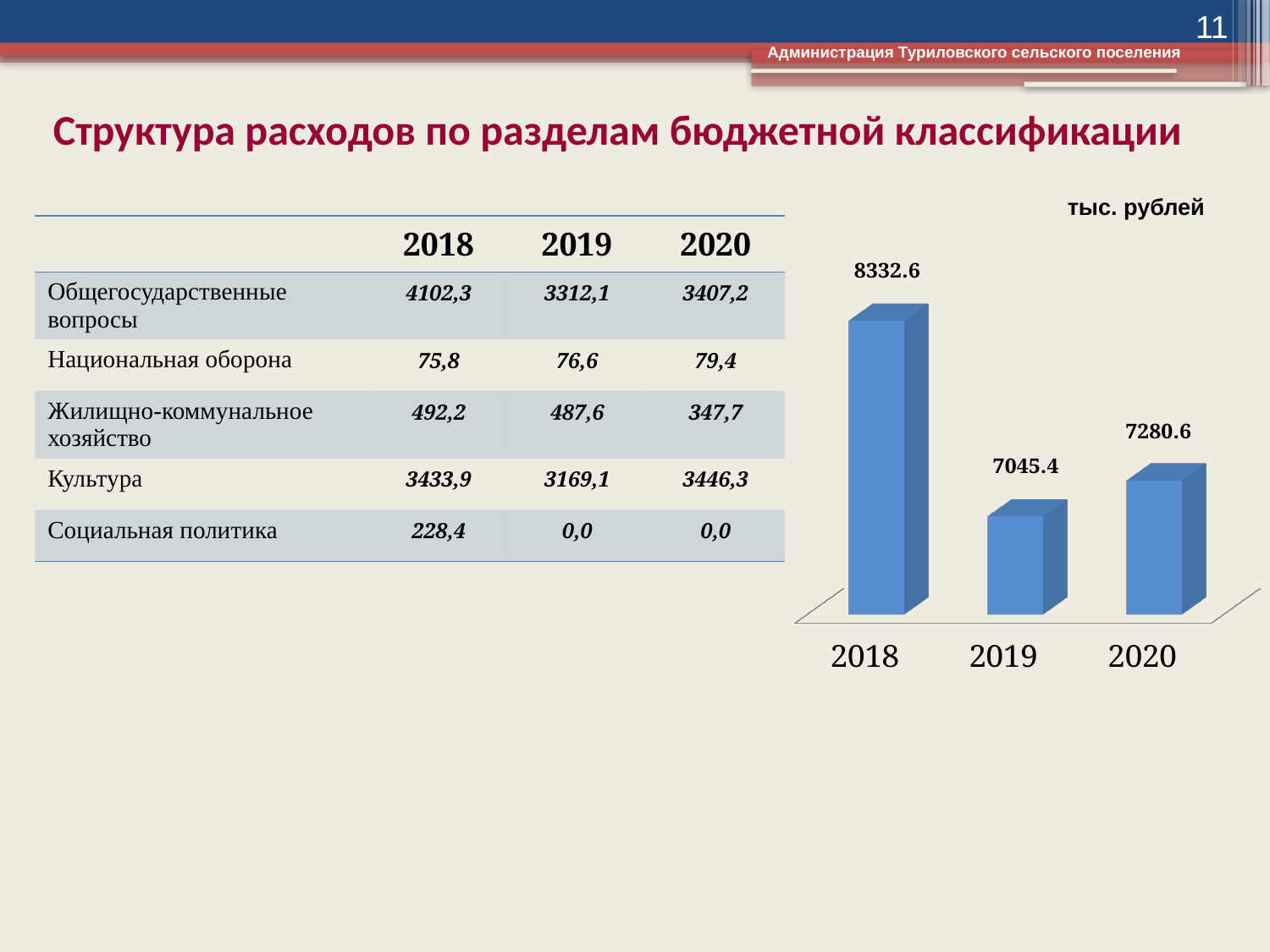
Which year has the lowest value on the bar chart? 2019 What kind of chart is shown on the slide? bar chart What is the difference between the 2020 and 2019 values on the bar chart? 235.2 Does the value on the bar chart rise or fall from 2018 to 2019? fall How many bars are shown on the bar chart? 3 Which is larger on the bar chart, the value for 2019 or the value for 2020? 2020 What unit is indicated above the bar chart? тыс. рублей What is the value shown for 2020 on the bar chart? 7280.6 What is the value shown for 2019 on the bar chart? 7045.4 Which year has the highest value on the bar chart? 2018 What is the value shown for 2018 on the bar chart? 8332.6 What is the difference between the 2018 and 2019 values on the bar chart? 1287.2